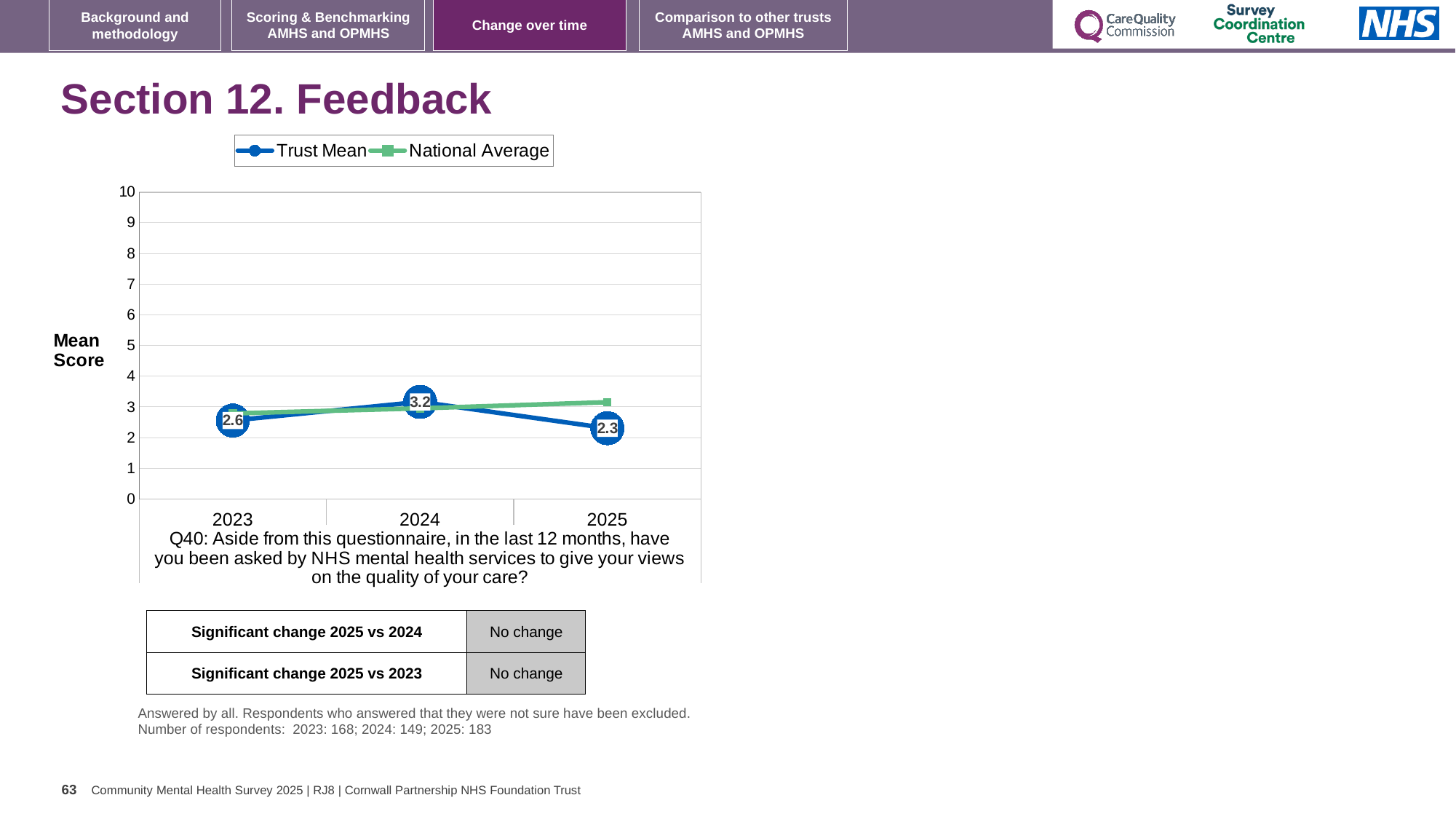
In which year is the Trust Mean lowest? 2025 What is the difference between the Trust Mean in 2024 and in 2025? 0.9 Is the National Average value for 2025 greater or less than 4? less What is the Trust Mean value for 2023? 2.6 How many series does the legend list? 2 What is the Trust Mean value for 2024? 3.2 Which is larger in 2025, the Trust Mean or the National Average? National Average In which year is the Trust Mean highest? 2024 What kind of chart is shown on the slide? Line chart What is the Trust Mean value for 2025? 2.3 How many years are plotted on the x axis? 3 Does the Trust Mean rise or fall from 2024 to 2025? Fall